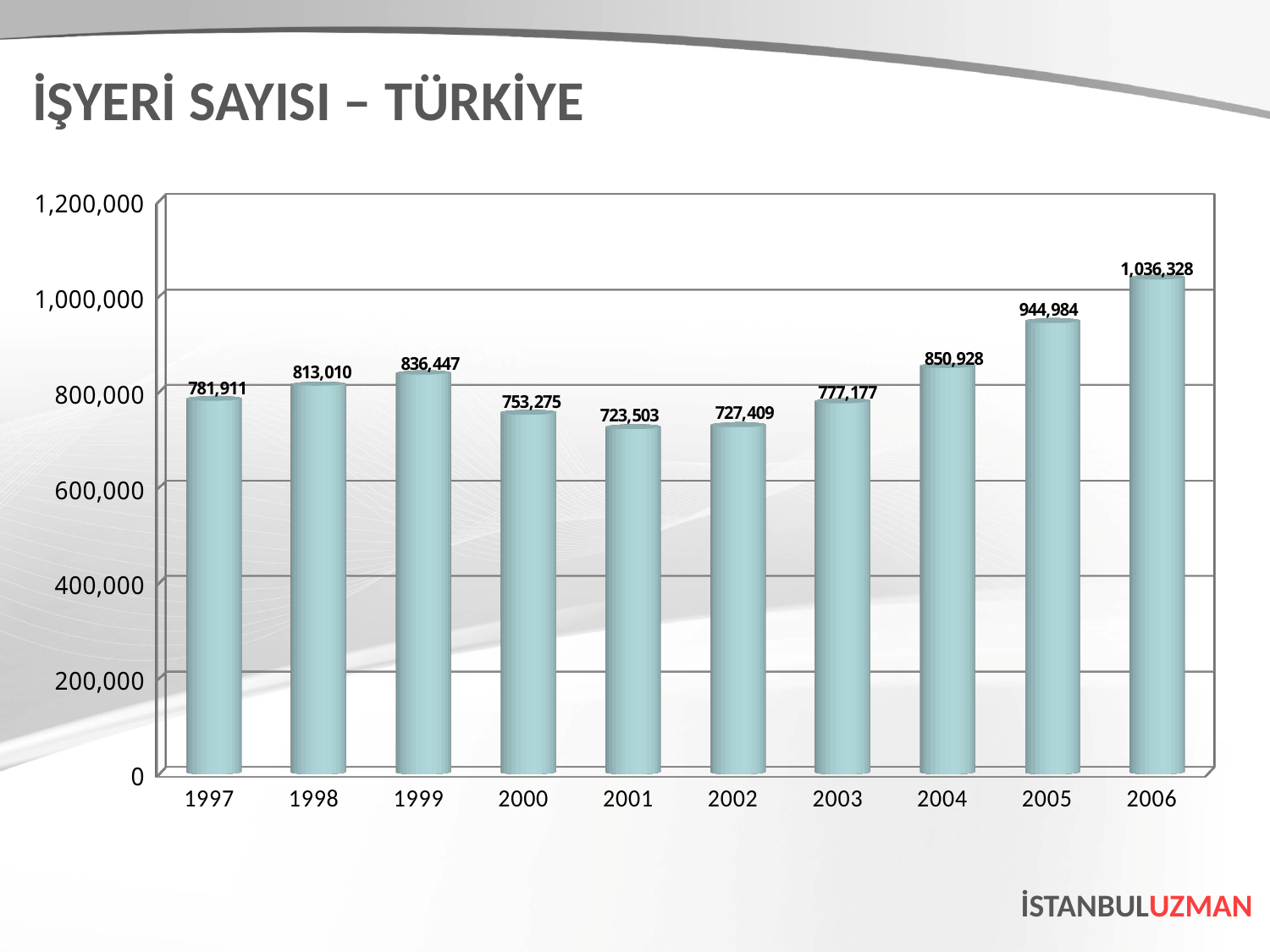
What is the difference between the values for 2006 and 2005? 91,344 What is the value for 2001? 723,503 Which year has the lowest value? 2001 What is the value for 1999? 836,447 How many years are shown on the x axis? 10 What kind of chart is shown on the slide? bar chart Is the value for 2005 greater or less than 1,000,000? less Which is larger, the value for 2004 or the value for 2003? 2004 What is the title of the chart? İŞYERİ SAYISI – TÜRKİYE Which year has the highest value? 2006 What is the difference between the values for 1999 and 1997? 54,536 What is the value for 2006? 1,036,328